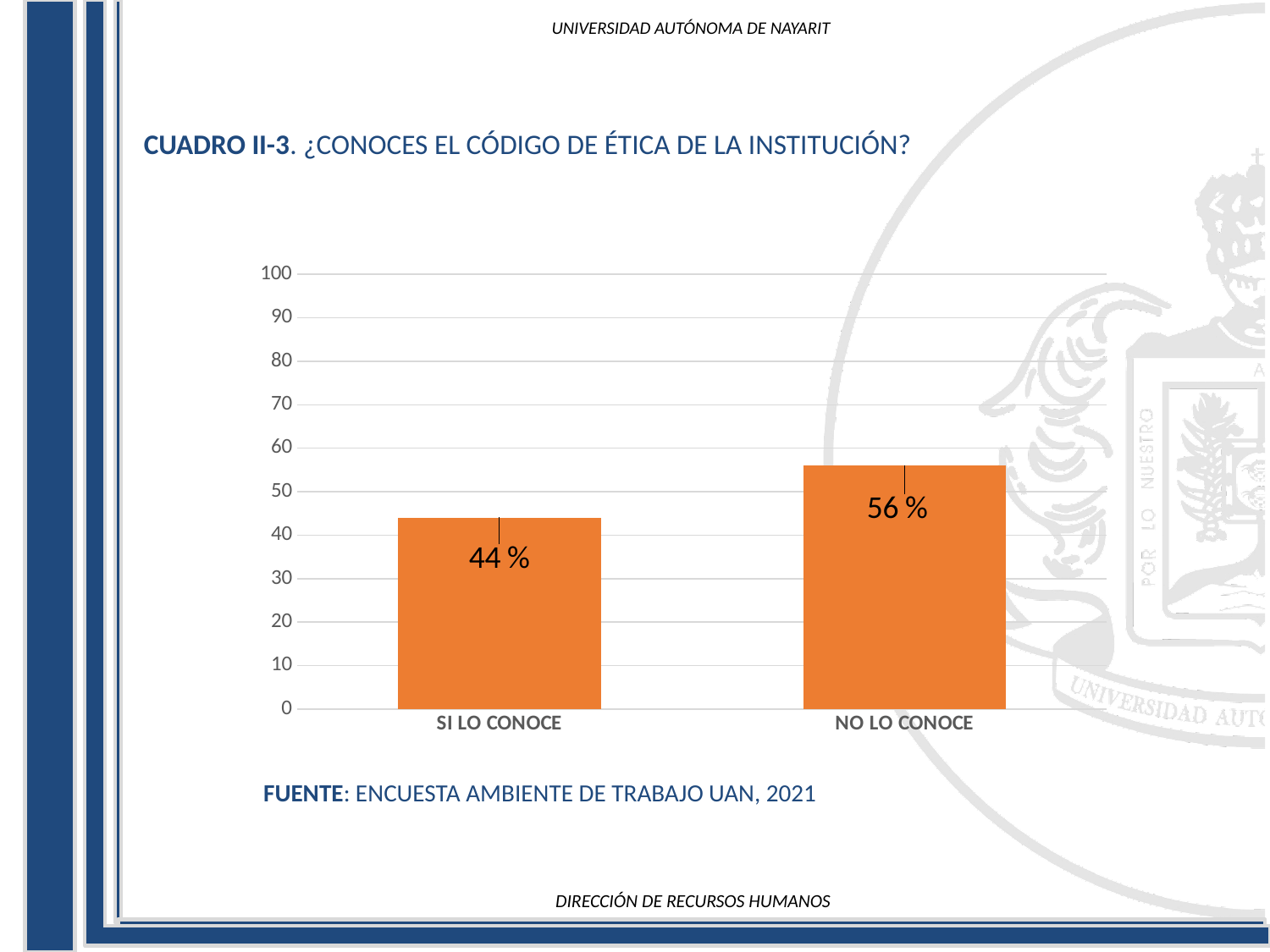
What is the value for SI LO CONOCE? 44 % What is the source cited below the chart? ENCUESTA AMBIENTE DE TRABAJO UAN, 2021 What is the value for NO LO CONOCE? 56 % Which category has the lowest value? SI LO CONOCE Is the value for NO LO CONOCE greater or less than 50? greater What kind of chart is shown on the slide? bar chart Which category has the highest value? NO LO CONOCE How many categories are shown in the chart? 2 Which is larger, the value for SI LO CONOCE or the value for NO LO CONOCE? NO LO CONOCE What is the title of the chart on the slide? CUADRO II-3. ¿CONOCES EL CÓDIGO DE ÉTICA DE LA INSTITUCIÓN? What is the difference between the values for NO LO CONOCE and SI LO CONOCE? 12 % Is the value for SI LO CONOCE greater or less than 50? less